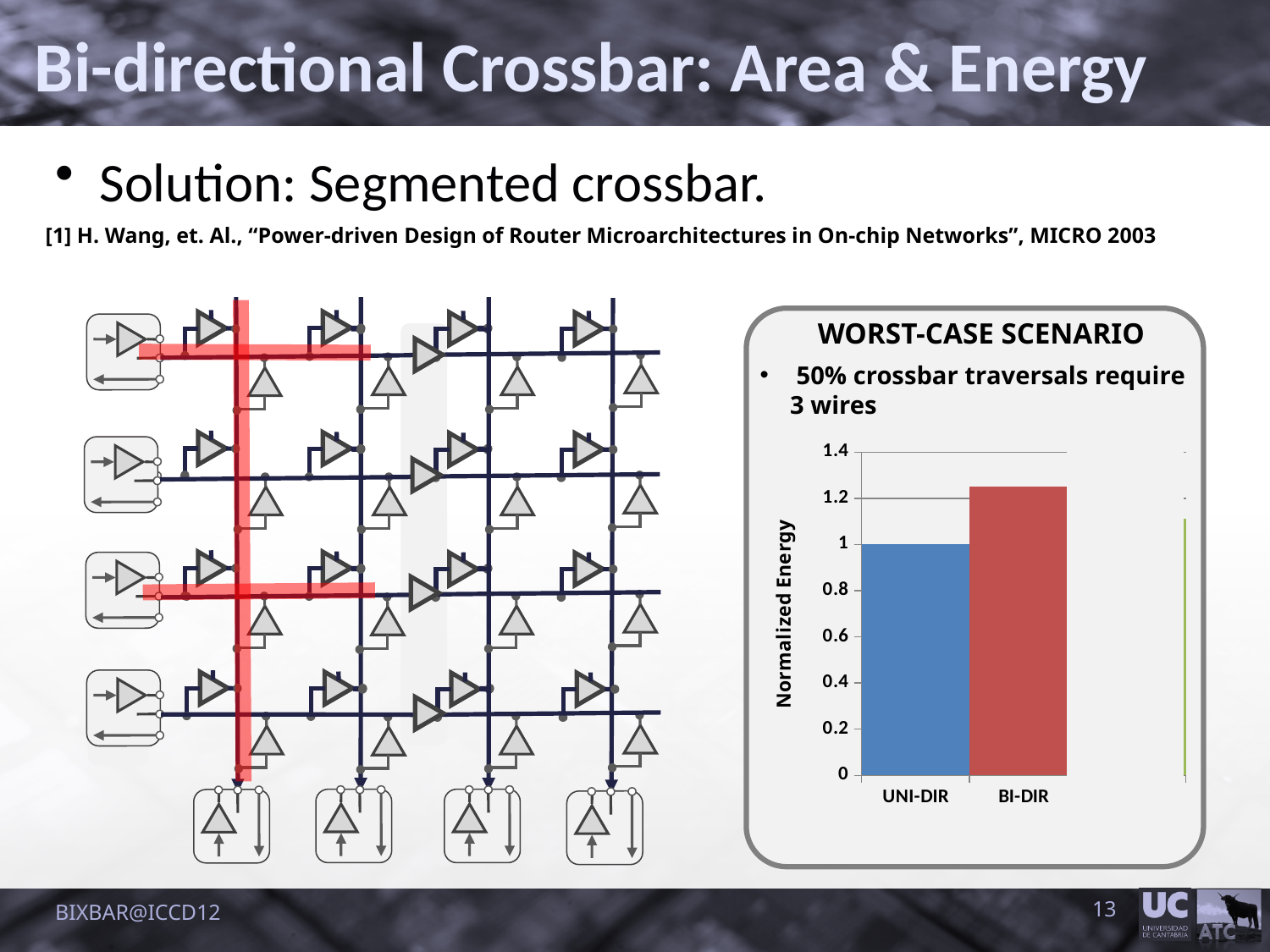
What is the Normalized Energy value for UNI-DIR in the bar chart? 1 Is the Normalized Energy for BI-DIR greater or less than 1.4? less What is the maximum value shown on the y axis of the bar chart? 1.4 What type of chart is shown on the slide? bar chart What is the label of the y axis of the bar chart? Normalized Energy Is the Normalized Energy for BI-DIR greater or less than 1.2? greater Which is larger in the bar chart, the value for UNI-DIR or the value for BI-DIR? BI-DIR Which category has the lowest Normalized Energy in the bar chart? UNI-DIR How many categories are shown on the x axis of the bar chart? 2 Which category has the highest Normalized Energy in the bar chart? BI-DIR Do the values rise or fall from UNI-DIR to BI-DIR along the x axis? rise Is the Normalized Energy for UNI-DIR greater or less than 1.2? less